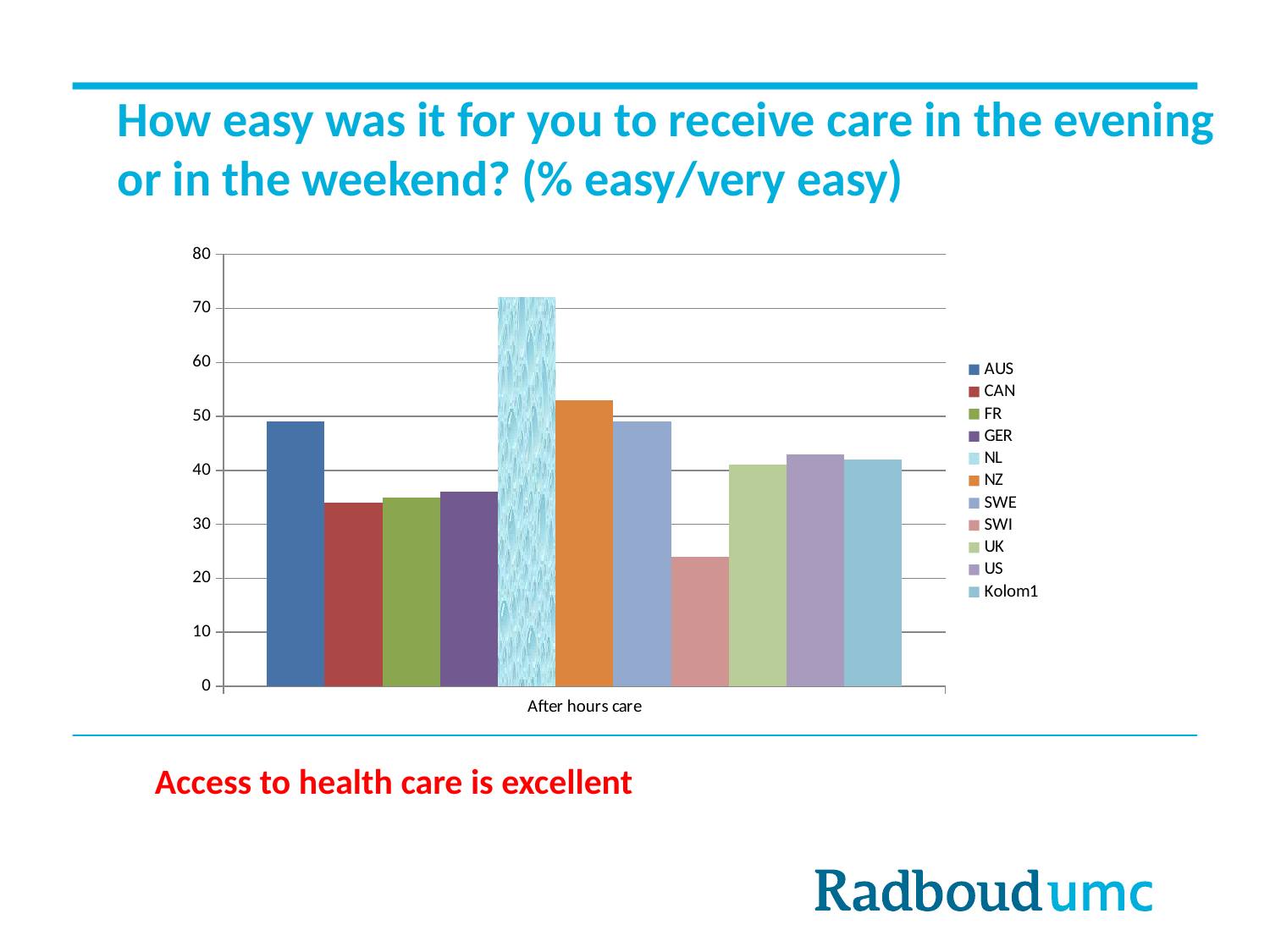
What kind of chart is shown on the slide? bar chart Which is larger, the value for AUS or the value for CAN? AUS Is the value for CAN greater or less than 40? less Is the value for SWI greater or less than 30? less What is the last entry listed in the legend? Kolom1 Which series has the lowest bar? SWI What is the category label shown on the x axis? After hours care Which series has the highest bar? NL How many series does the legend list? 11 Is the value for NL greater or less than 60? greater Which is larger, the value for NL or the value for NZ? NL